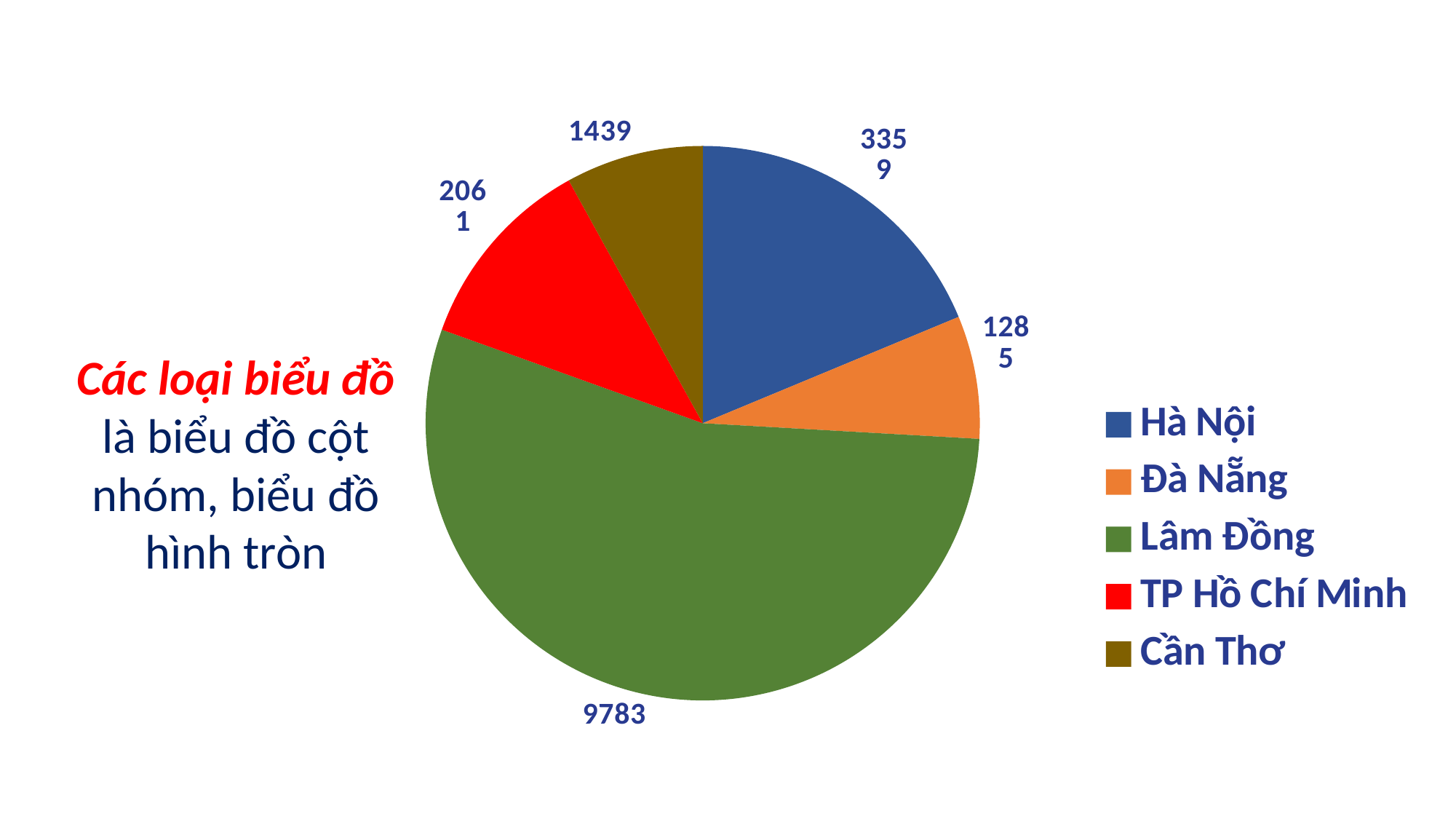
How many categories does the pie chart show? 5 Which category has the largest slice of the pie chart? Lâm Đồng What value is shown for Đà Nẵng in the pie chart? 1285 Which category has the smallest slice of the pie chart? Đà Nẵng What is the difference between the values for Lâm Đồng and Hà Nội? 6424 Which is larger, the value for Hà Nội or the value for TP Hồ Chí Minh? Hà Nội What is the difference between the values for TP Hồ Chí Minh and Cần Thơ? 622 What value is shown for Cần Thơ in the pie chart? 1439 What value is shown for Hà Nội in the pie chart? 3359 What value is shown for Lâm Đồng in the pie chart? 9783 What kind of chart is shown on the slide? Pie chart What value is shown for TP Hồ Chí Minh in the pie chart? 2061